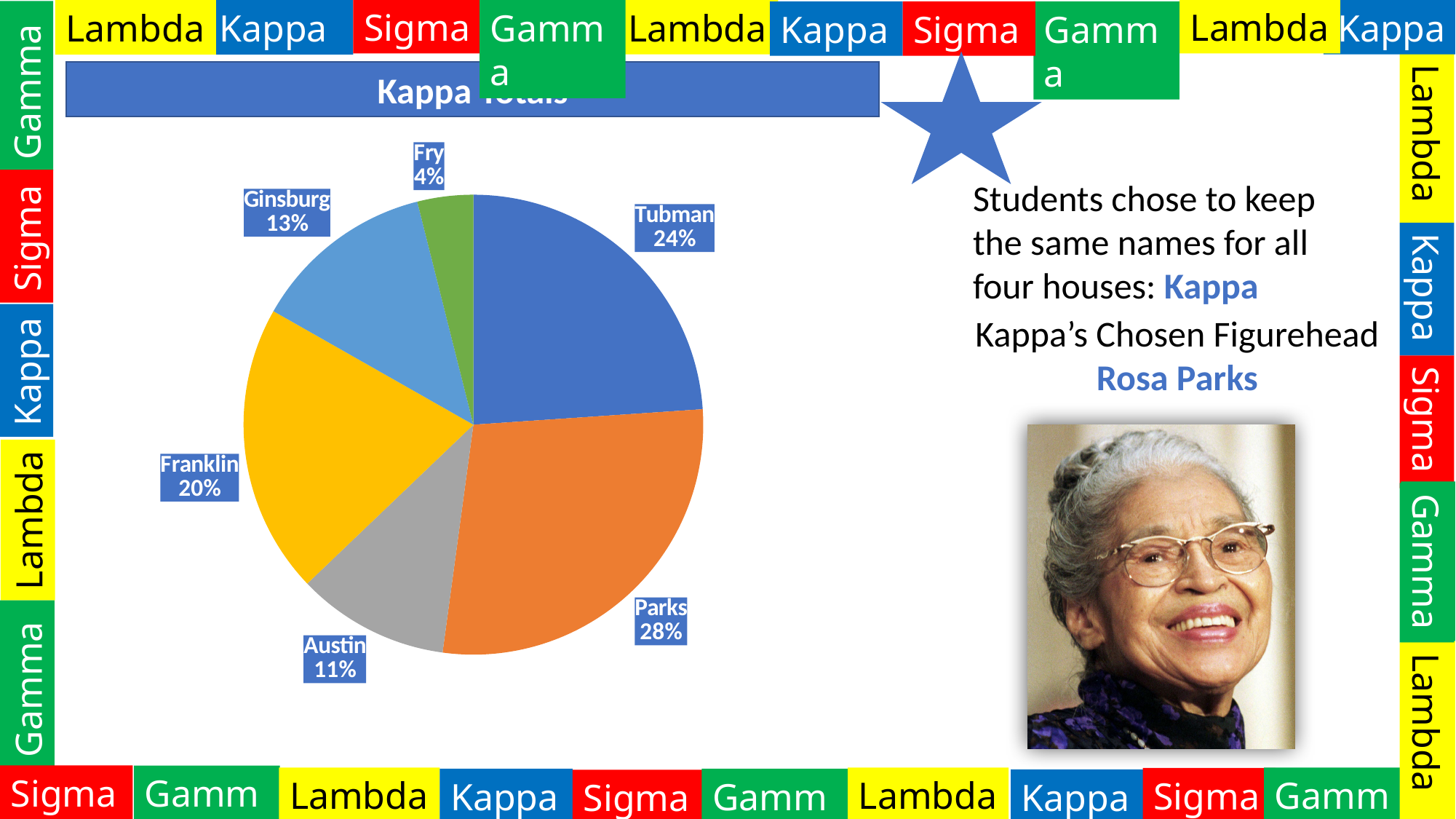
What share of the pie does Tubman have? 24% What share of the pie does Fry have? 4% What share of the pie does Ginsburg have? 13% What share of the pie does Parks have? 28% What kind of chart is shown on the slide? Pie chart Which category has the largest slice of the pie? Parks Which is larger, the share for Franklin or the share for Ginsburg? Franklin Which category has the smallest slice of the pie? Fry What is the difference in percentage points between Parks and Tubman? 4 What colour is the Austin slice of the pie? Grey What share of the pie does Franklin have? 20% How many slices does the pie chart have? 6